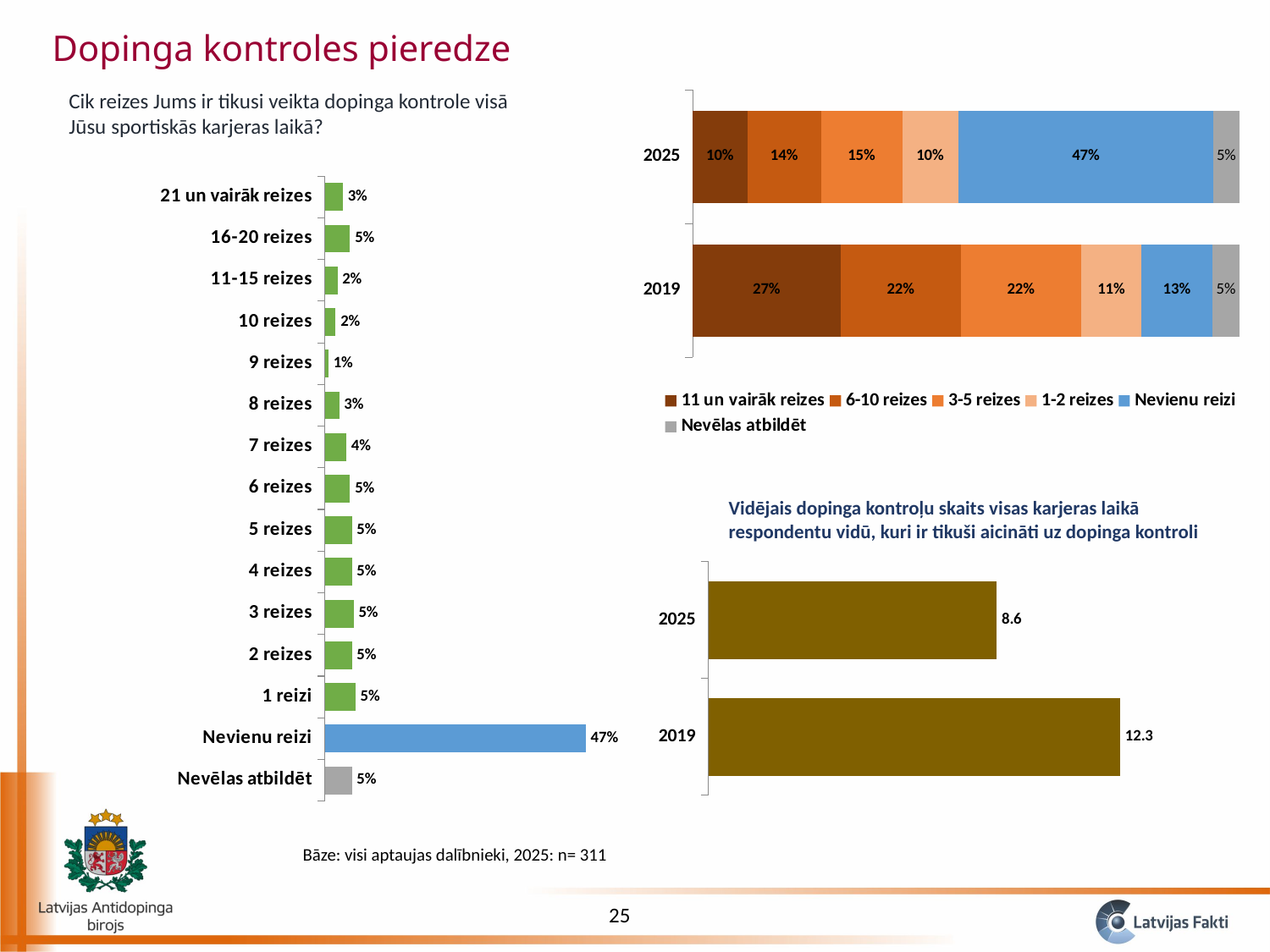
In the stacked bar chart at the top right, how many series does the legend list? 6 In the bar chart on the left of the slide, how many categories are shown? 15 In the stacked bar chart at the top right, which year has the larger share for "Nevienu reizi", 2025 or 2019? 2025 In the stacked bar chart at the top right, what is the 2025 value for "Nevienu reizi"? 47% In the stacked bar chart at the top right, what is the difference between the 2019 and 2025 values for "11 un vairāk reizes"? 17 percentage points In the chart titled "Vidējais dopinga kontroļu skaits visas karjeras laikā respondentu vidū, kuri ir tikuši aicināti uz dopinga kontroli", what is the value for 2019? 12.3 In the bar chart on the left of the slide, what is the value for "Nevienu reizi"? 47% In the stacked bar chart at the top right, what is the 2019 value for "11 un vairāk reizes"? 27% What kind of chart is the chart at the bottom right of the slide? Bar chart In the bar chart on the left of the slide, which category has the lowest value? 9 reizes In the bar chart on the left of the slide, what is the value for "16-20 reizes"? 5% In the chart titled "Vidējais dopinga kontroļu skaits visas karjeras laikā respondentu vidū, kuri ir tikuši aicināti uz dopinga kontroli", what is the difference between the 2019 and 2025 values? 3.7